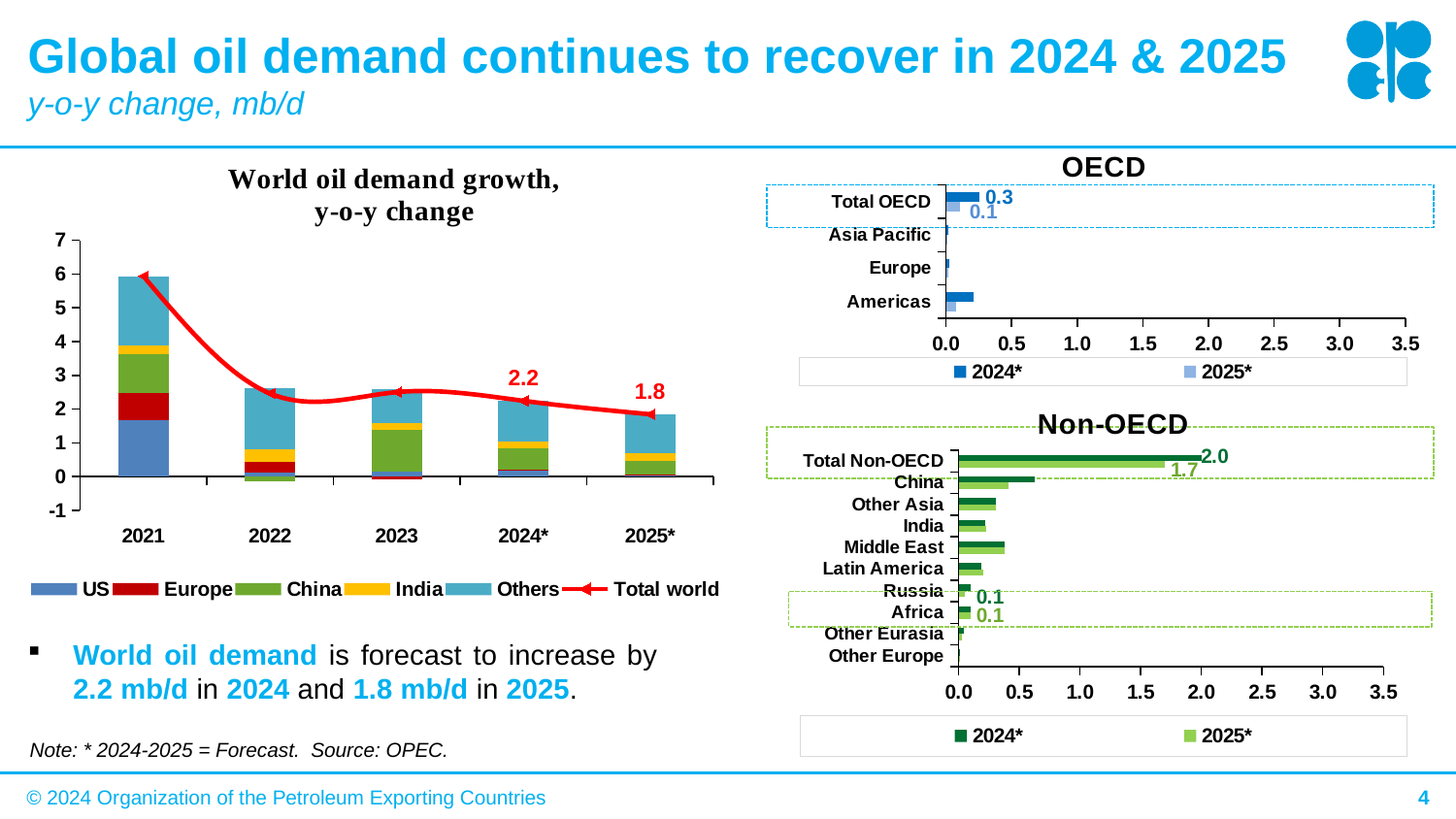
In the Non-OECD chart, what is the difference between the Total Non-OECD values for 2024* and 2025*? 0.3 In the Non-OECD chart, which region other than Total Non-OECD has the highest 2024* value? China In the 'World oil demand growth, y-o-y change' chart, what is the difference between the Total world values for 2024* and 2025*? 0.4 In the 'World oil demand growth, y-o-y change' chart, what is the Total world value for 2024*? 2.2 In the 'World oil demand growth, y-o-y change' chart, is the total stacked bar for 2021 greater or less than 5? greater In the 'World oil demand growth, y-o-y change' chart, how many series does the legend list? 6 In the Non-OECD chart, what is the value for Total Non-OECD in 2025*? 1.7 In the OECD chart, what is the value for Total OECD in 2024*? 0.3 What kind of chart is the 'World oil demand growth, y-o-y change' chart? combination bar and line chart (stacked bars with a line) In the 'World oil demand growth, y-o-y change' chart, what is the Total world value for 2025*? 1.8 In the OECD chart, which is larger for Total OECD: 2024* or 2025*? 2024* In the OECD chart, is the value for Americas in 2024* greater or less than 0.5? less